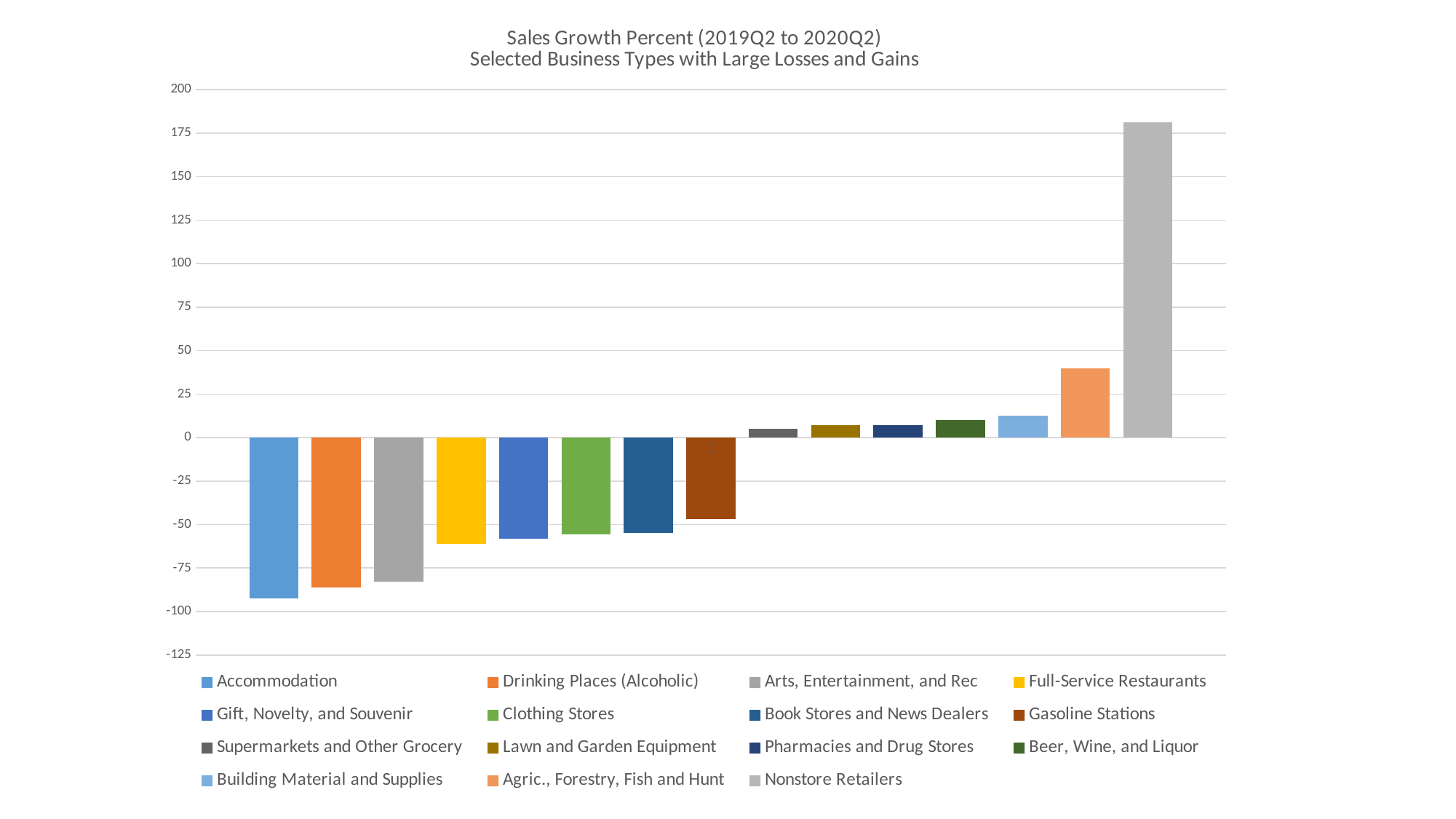
What is the first line of the chart's title? Sales Growth Percent (2019Q2 to 2020Q2) Is the value for Accommodation greater or less than -75? less Which has the larger sales growth percent, Agric., Forestry, Fish and Hunt or Building Material and Supplies? Agric., Forestry, Fish and Hunt Is the value for Full-Service Restaurants greater or less than -50? less What kind of chart is shown on the slide? bar chart Which business type has the lowest sales growth percent? Accommodation Is the value for Agric., Forestry, Fish and Hunt greater or less than 50? less Which business type has the highest sales growth percent? Nonstore Retailers How many business types (bars) are plotted in the chart? 15 How many entries does the legend list? 15